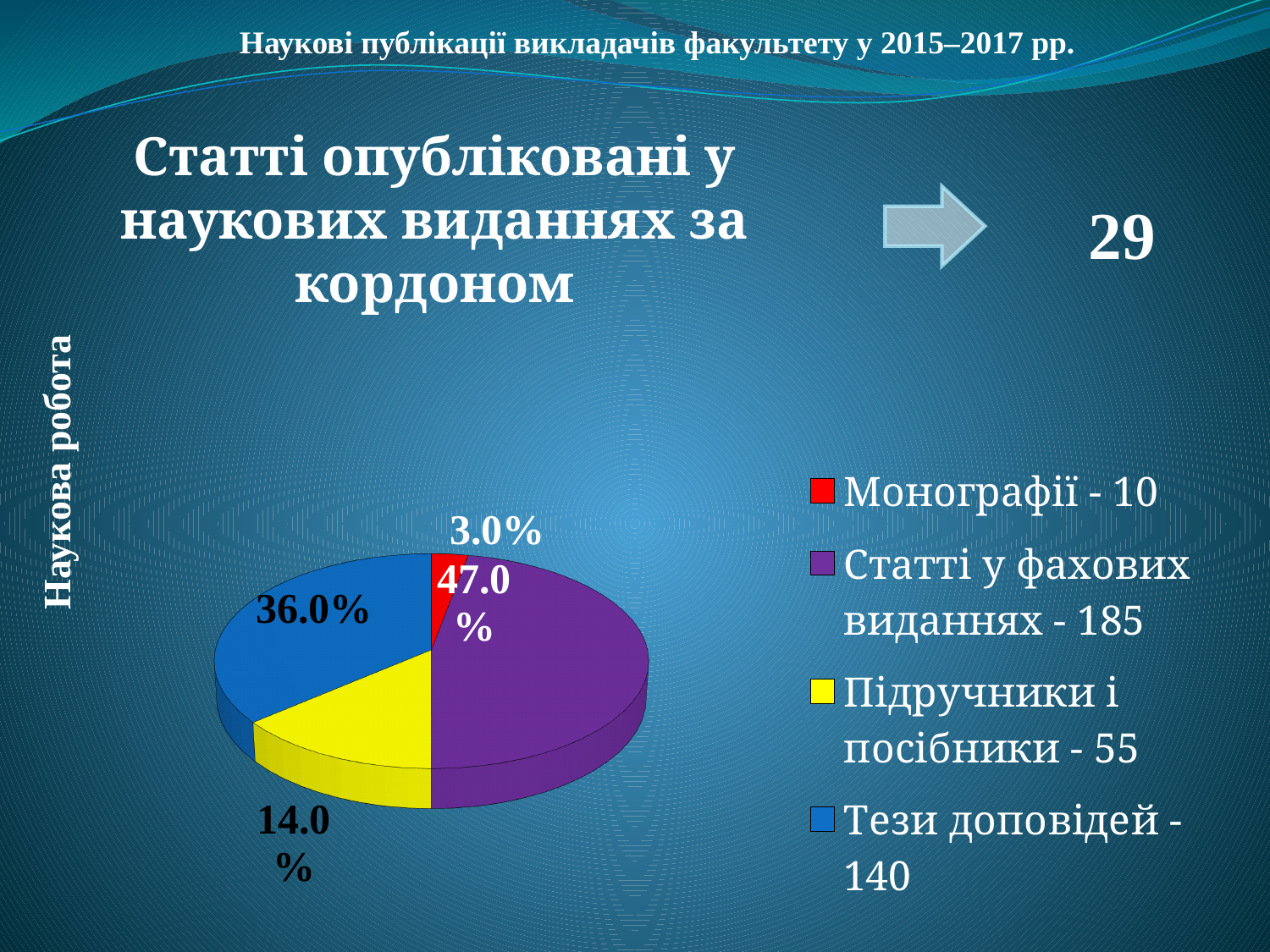
What share of the pie does "Статті у фахових виданнях - 185" take? 47.0% What colour is the "Підручники і посібники - 55" slice? yellow What share of the pie does "Монографії - 10" take? 3.0% What share of the pie does "Тези доповідей - 140" take? 36.0% How many entries does the legend list? 4 Which category has the smallest slice of the pie? Монографії - 10 Which slice is larger: "Підручники і посібники" or "Тези доповідей"? Тези доповідей Which category has the largest slice of the pie? Статті у фахових виданнях - 185 How many slices does the pie chart have? 4 What is the difference in percentage points between the "Статті у фахових виданнях" slice and the "Тези доповідей" slice? 11.0% What kind of chart is shown on the slide? pie chart